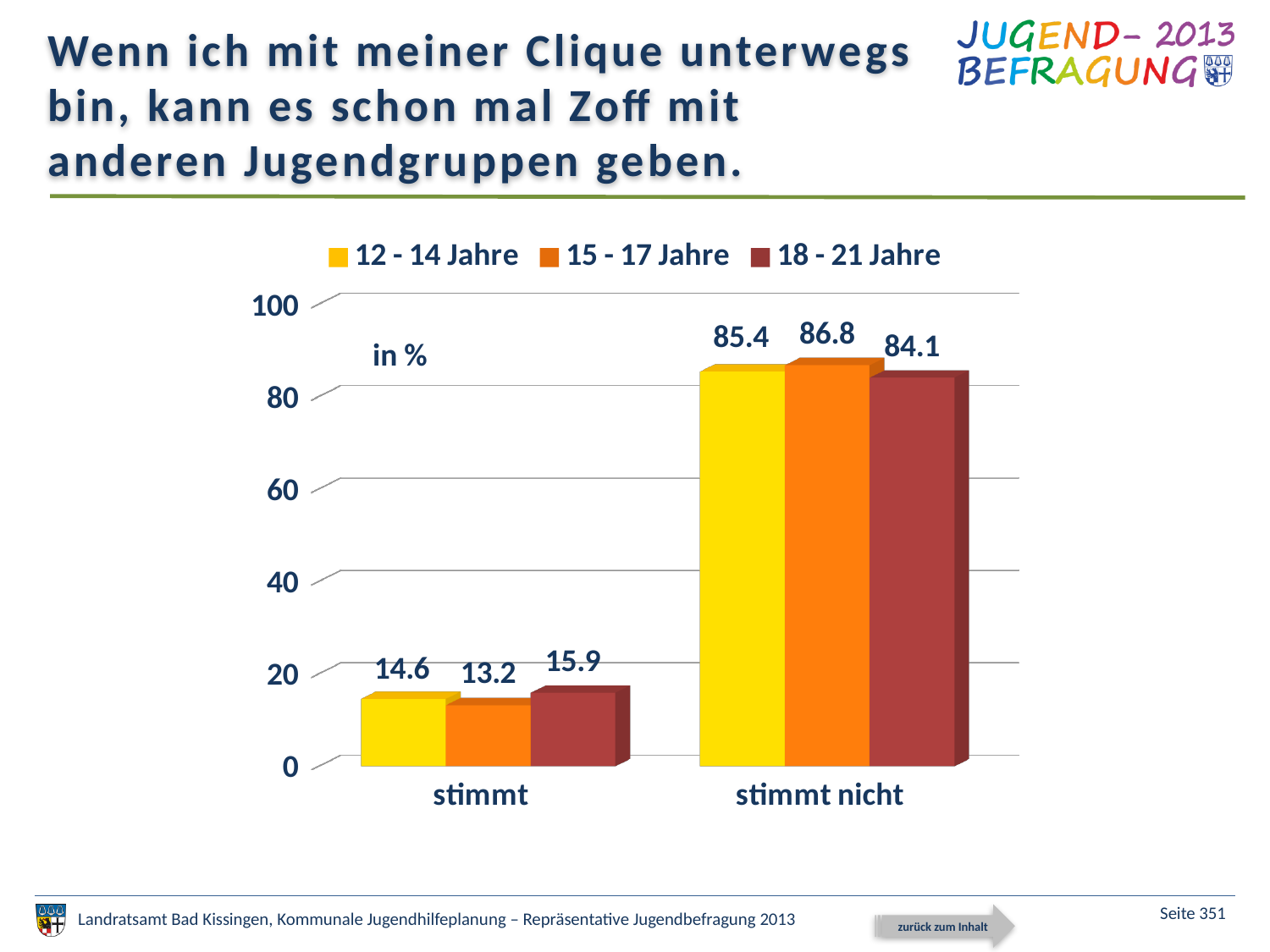
What is the difference between the 18 - 21 Jahre and 15 - 17 Jahre values in the "stimmt" category? 2.7 How many categories are shown on the x axis? 2 Which age group has the lowest value in the "stimmt" category? 15 - 17 Jahre Which is larger: the 12 - 14 Jahre value for "stimmt nicht" or the 18 - 21 Jahre value for "stimmt nicht"? 12 - 14 Jahre What is the value for the 15 - 17 Jahre series in the "stimmt nicht" category? 86.8 Is the value for 12 - 14 Jahre in the "stimmt nicht" category greater or less than 80? greater Which age group has the highest value in the "stimmt nicht" category? 15 - 17 Jahre What is the value for the 18 - 21 Jahre series in the "stimmt" category? 15.9 How many series does the legend list? 3 What kind of chart is shown on the slide? bar chart What unit is indicated on the chart for the values? in % What is the value for the 12 - 14 Jahre series in the "stimmt" category? 14.6